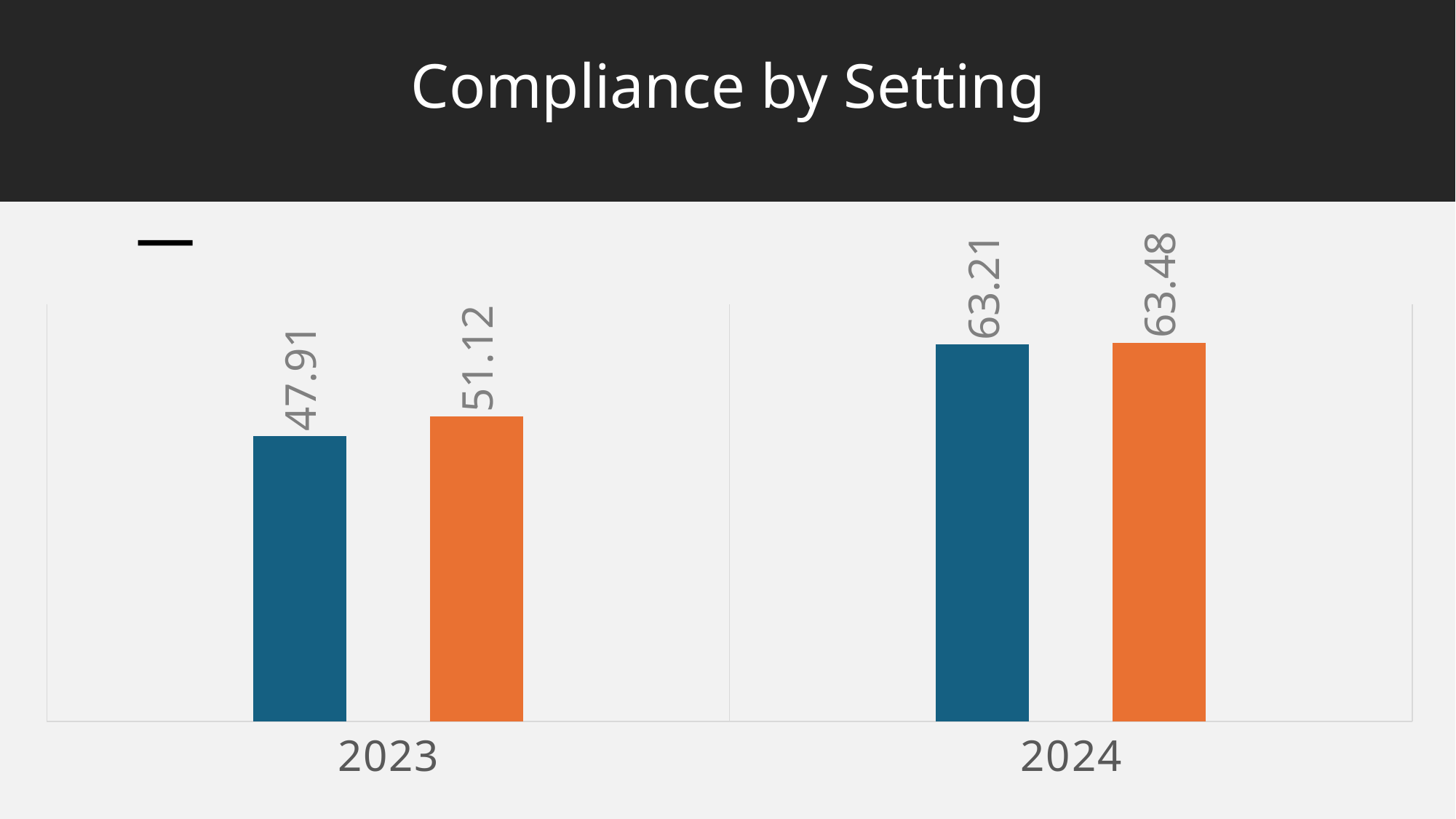
Which bar has the lowest value on the chart? The blue bar for 2023 Which bar has the highest value on the chart? The orange bar for 2024 What is the difference between the orange and blue bars for 2023? 3.21 Which is larger for 2023, the blue bar or the orange bar? The orange bar What is the difference between the blue bar for 2024 and the blue bar for 2023? 15.30 What is the value of the blue bar for 2023? 47.91 Do the blue bar values rise or fall from 2023 to 2024? Rise What is the value of the blue bar for 2024? 63.21 What is the value of the orange bar for 2023? 51.12 What kind of chart is shown on the slide? Bar chart What is the value of the orange bar for 2024? 63.48 How many categories are shown on the x axis? 2